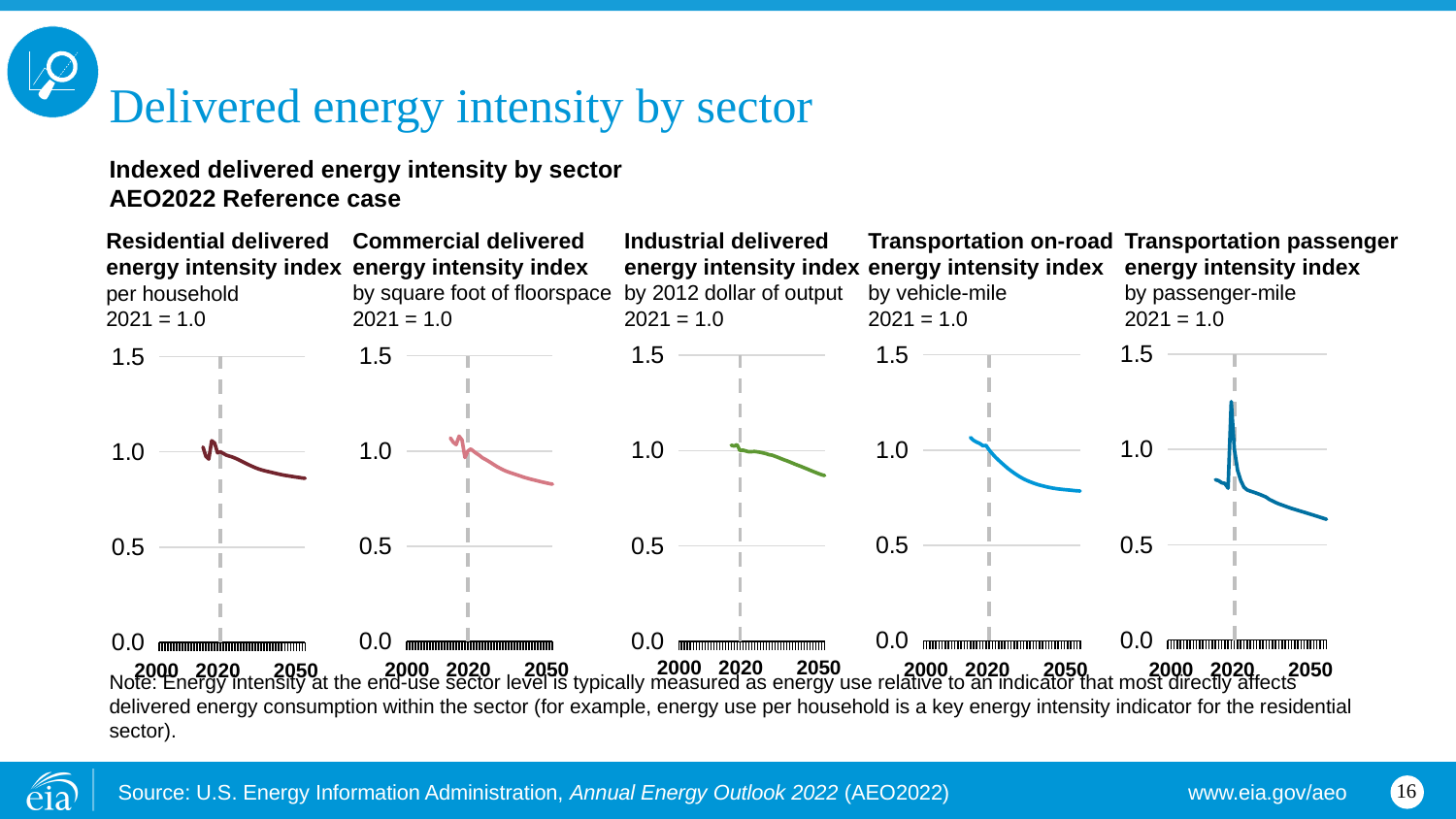
Which of the five charts reaches the highest index value at any point? Transportation passenger energy intensity index What kind of chart is used for the Residential delivered energy intensity index? line chart Which of the five charts has the lowest index value in 2050? Transportation passenger energy intensity index How many charts are shown on the slide? 5 In the Industrial delivered energy intensity index chart, is the value in 2050 greater or less than 1.0? less In the Residential delivered energy intensity index chart, what is the index value in 2021? 1.0 In 2050, which is larger: the Residential delivered energy intensity index or the Transportation passenger energy intensity index? Residential delivered energy intensity index What is the unit basis for the Commercial delivered energy intensity index? by square foot of floorspace In the Transportation passenger energy intensity index chart, is the peak value greater or less than 1.0? greater In the Transportation on-road energy intensity index chart, does the value rise or fall from 2021 to 2050? fall Which AEO2022 case do the charts show? Reference case In the Transportation passenger energy intensity index chart, is the value in 2050 greater or less than 0.5? greater